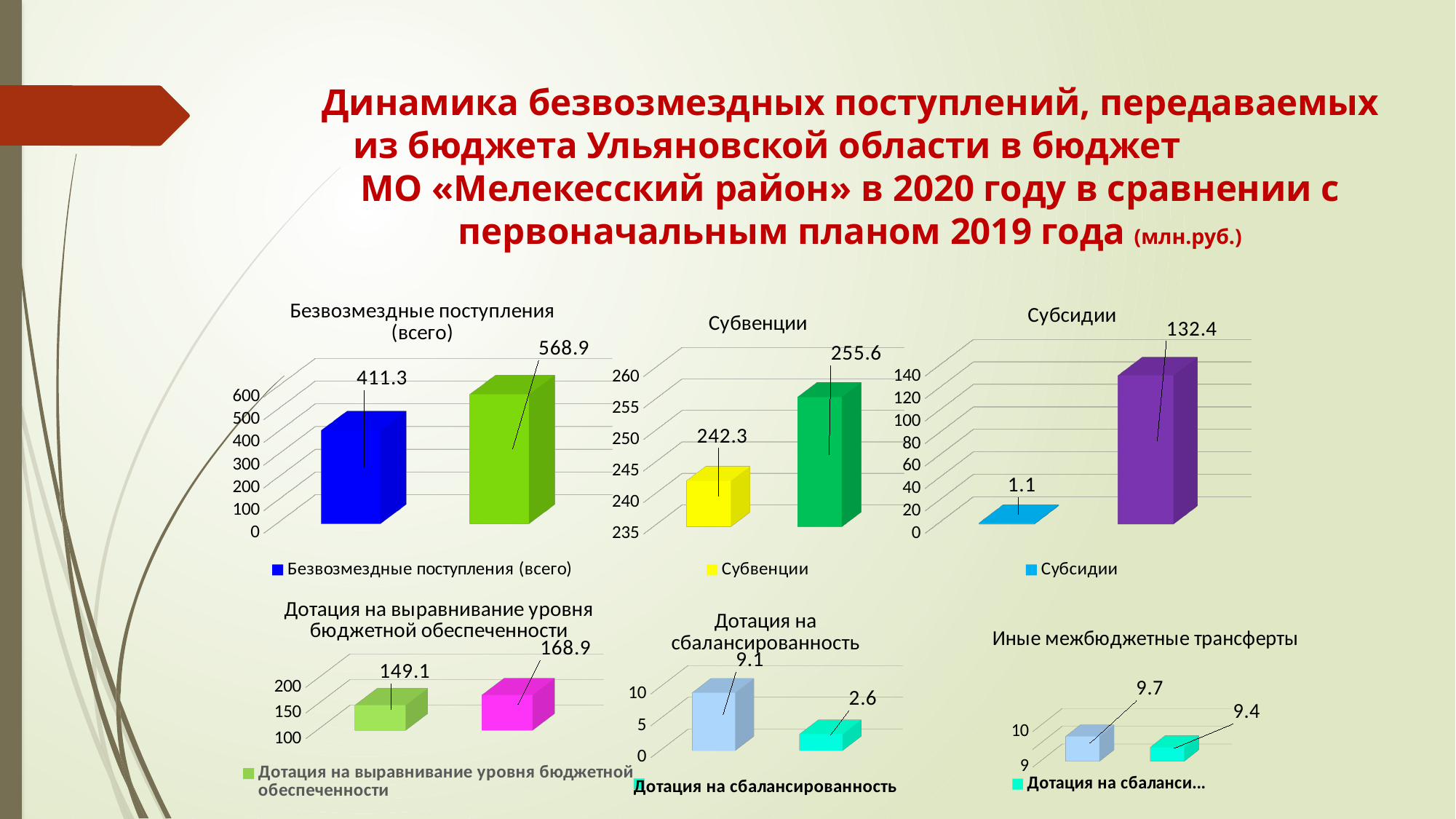
In the chart titled «Дотация на сбалансированность», what value is labelled on the right (cyan) bar? 2.6 In the chart titled «Субвенции», which bar is larger, the left (yellow) one or the right (green) one? the right (green) one In the chart titled «Безвозмездные поступления (всего)», what is the difference between the right bar and the left bar? 157.6 In the chart titled «Дотация на выравнивание уровня бюджетной обеспеченности», what value is labelled on the left (green) bar? 149.1 In the chart titled «Иные межбюджетные трансферты», what is the difference between the left bar and the right bar? 0.3 What kind of chart is the one titled «Дотация на сбалансированность»? bar chart In the chart titled «Безвозмездные поступления (всего)», what value is labelled on the right (green) bar? 568.9 How many bars are plotted in the chart titled «Субсидии»? 2 In the chart titled «Субсидии», what is the difference between the right bar and the left bar? 131.3 In the chart titled «Субвенции», what value is labelled on the right (green) bar? 255.6 In the chart titled «Безвозмездные поступления (всего)», what value is labelled on the left (blue) bar? 411.3 In the chart titled «Субсидии», what value is labelled on the left (light blue) bar? 1.1